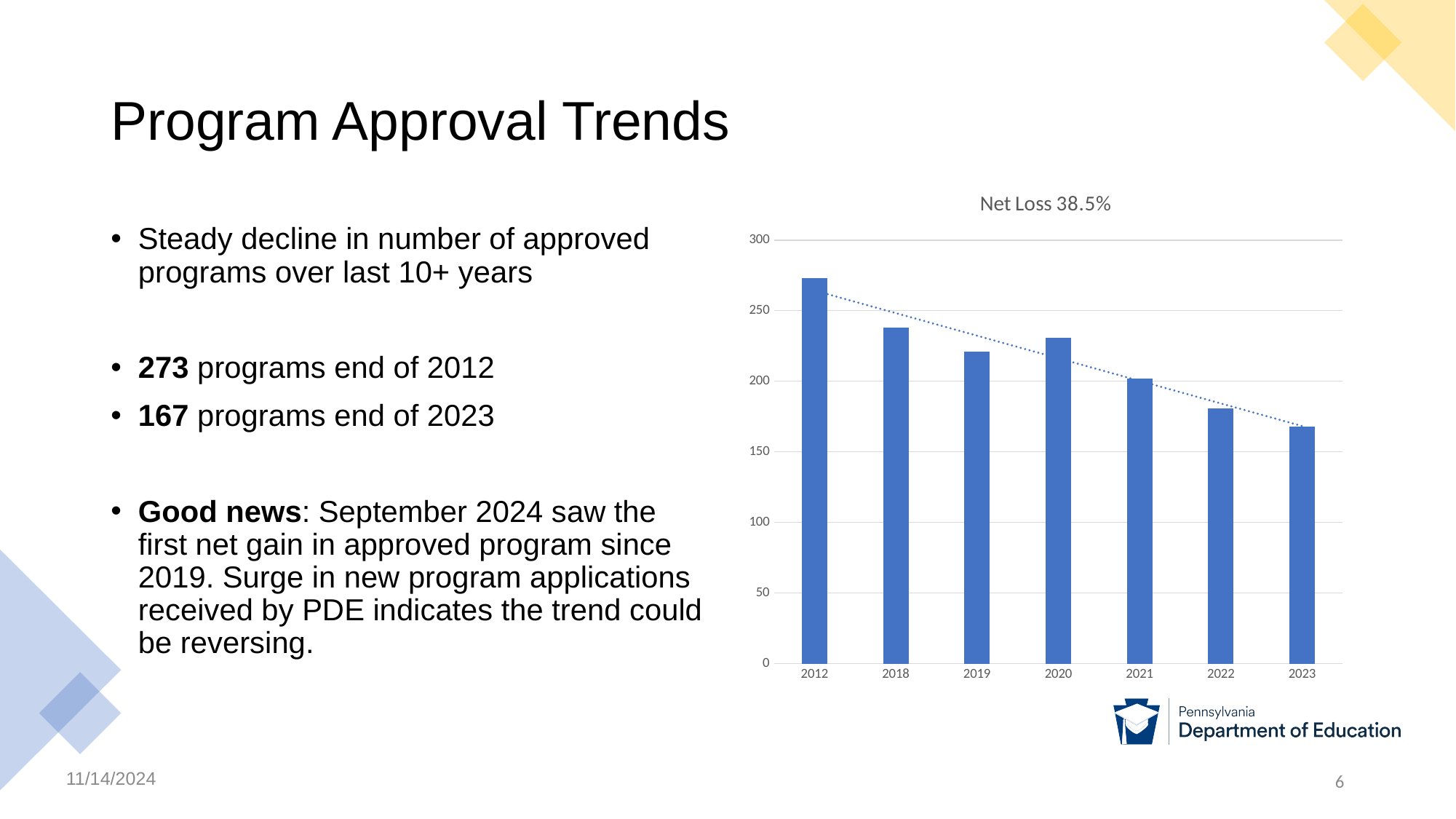
What is the difference between the number of programs at the end of 2012 and at the end of 2023? 106 Is the value for 2018 greater or less than 200? greater How many approved programs were there at the end of 2012? 273 What kind of chart is shown on the slide? bar chart Which year has the highest bar in the chart? 2012 Which year has the lowest bar in the chart? 2023 What is the title of the chart? Net Loss 38.5% How many years are shown on the x axis of the chart? 7 How many approved programs were there at the end of 2023? 167 Is the value for 2022 greater or less than 200? less Which year has the larger value, 2018 or 2019? 2018 Do the values in the chart generally rise or fall from 2012 to 2023? fall